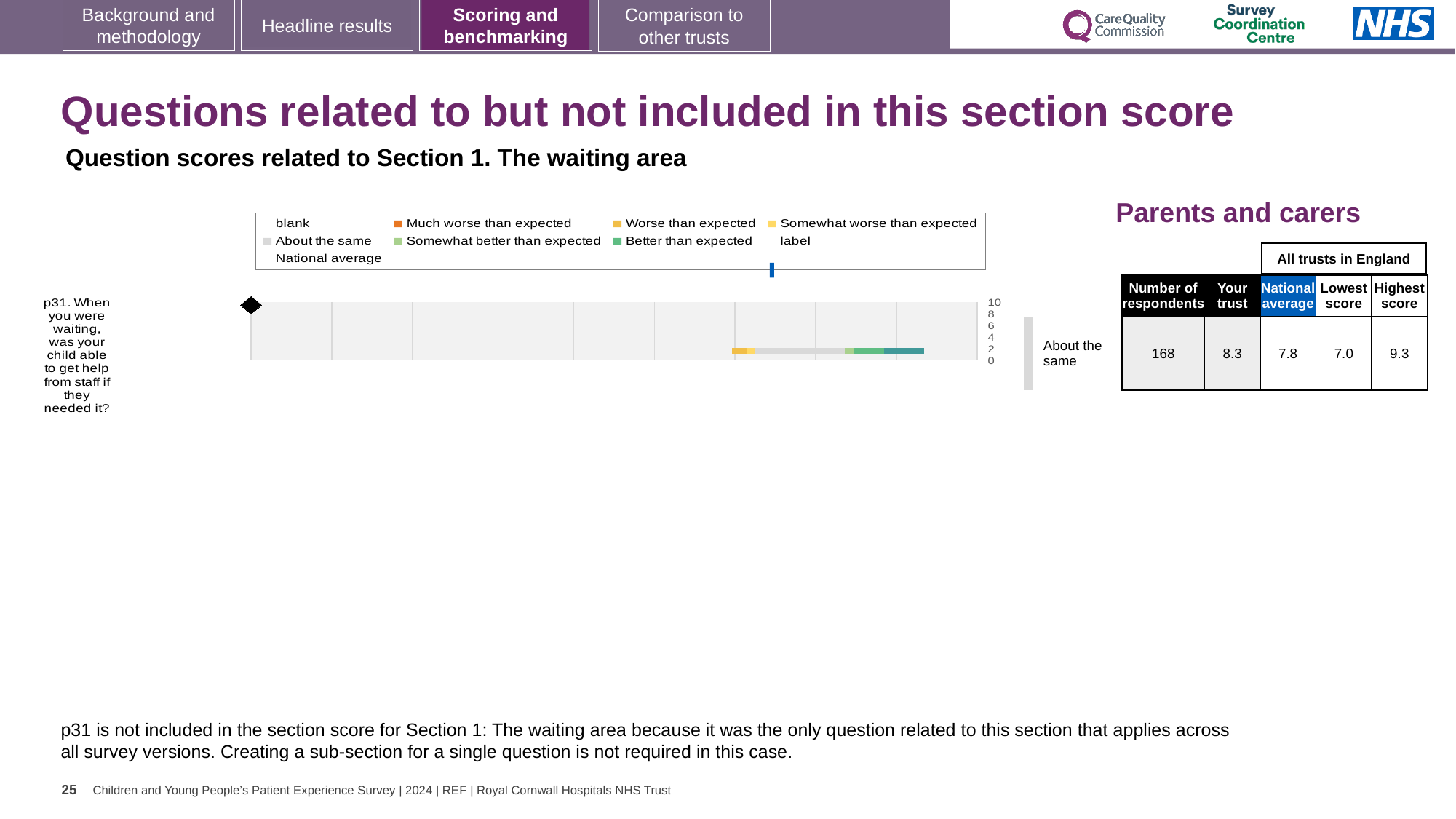
In the table, what is the difference between the Highest score and the Lowest score for p31? 2.3 How many questions (categories) are plotted in the chart? 1 In the table, what is the 'Your trust' score for p31? 8.3 In the table, what is the number of respondents for p31? 168 In the table, which is larger for p31: the 'Your trust' score or the National average? Your trust In the table, what is the Highest score among all trusts in England for p31? 9.3 What is the highest value shown on the chart's axis? 10 Which question is plotted in the chart? p31. When you were waiting, was your child able to get help from staff if they needed it? What kind of chart is shown on the slide? bar chart In the table, what is the National average score for p31? 7.8 How many entries does the chart legend list? 9 What rating label is shown next to the bar for p31? About the same